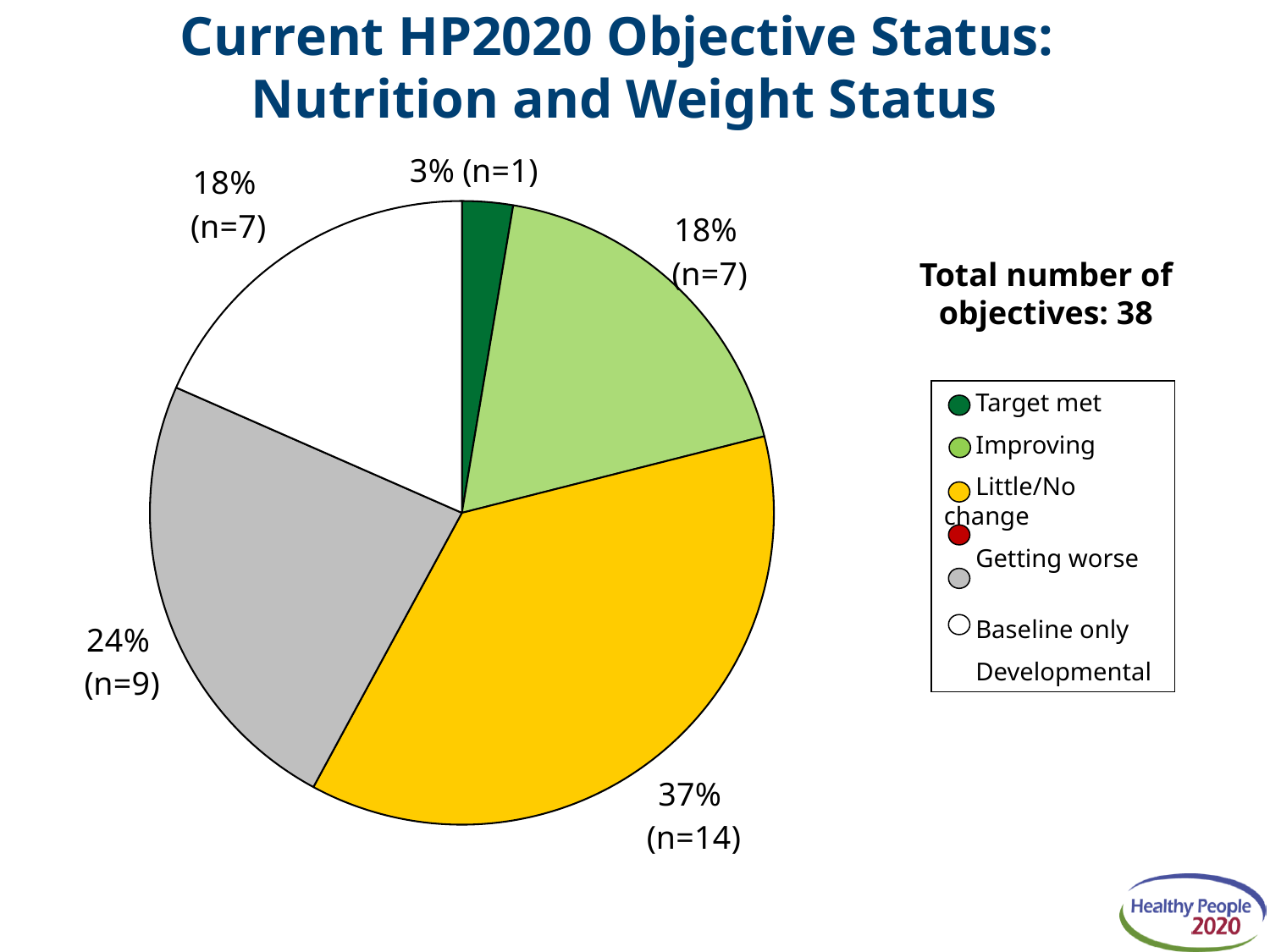
What is the difference in percentage points between the Little/No change slice and the gray slice? 13 percentage points What is the total number of objectives stated on the slide? 38 What percentage of objectives does the dark green slice (Target met) represent? 3% How many objectives are in the Target met (dark green) slice? n=1 Which slice of the pie is the smallest? Target met (3%) What kind of chart is shown on the slide? pie chart What percentage of objectives does the yellow slice (Little/No change) represent? 37% Which slice of the pie is the largest? Little/No change (37%) What percentage of objectives does the light green slice (Improving) represent? 18% How many entries does the legend list? 6 How many objectives are in the Little/No change (yellow) slice? n=14 What percentage does the gray slice represent? 24%